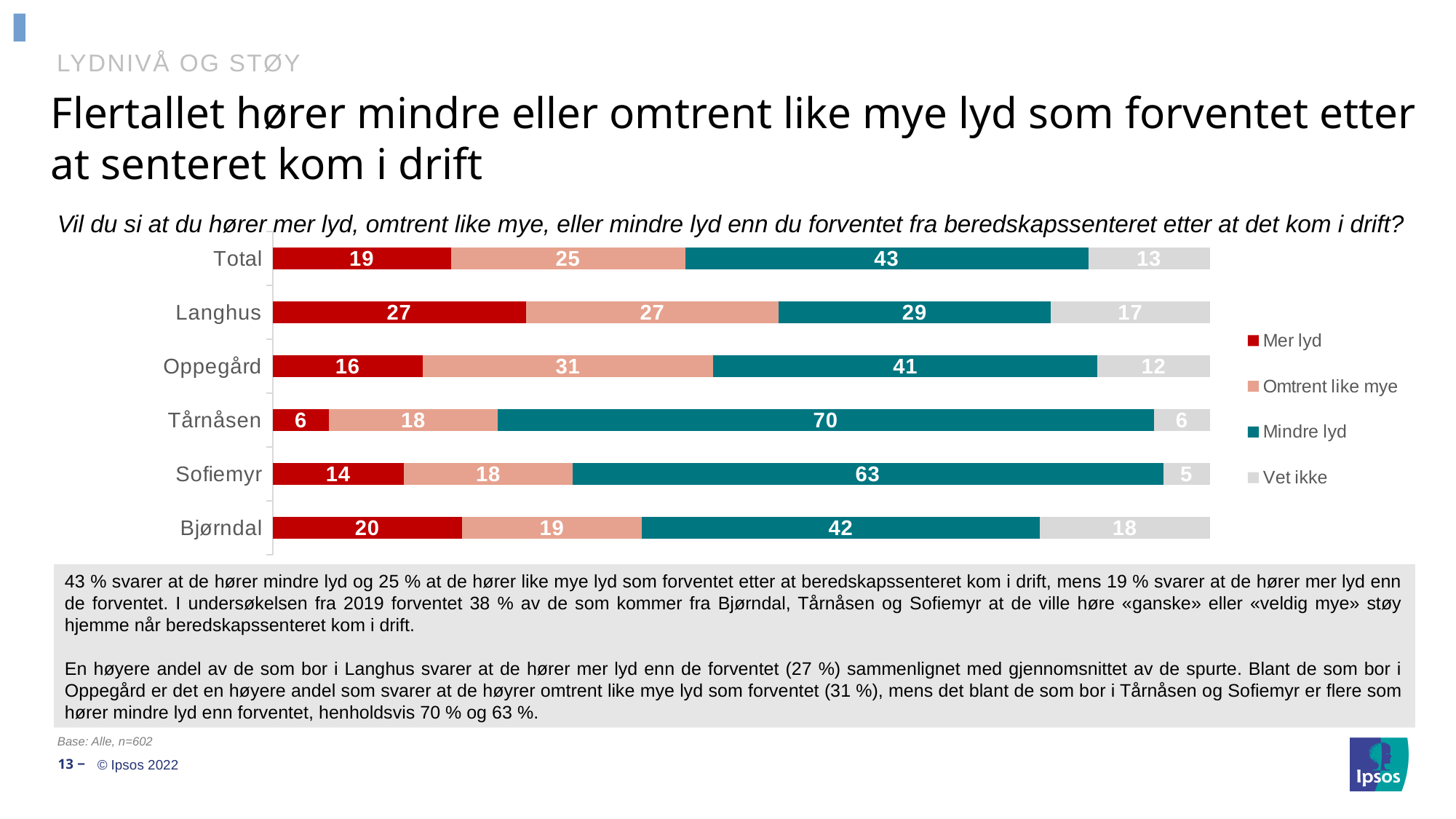
Which colour represents "Mindre lyd" in the chart? Teal What is the total of the stacked bar for Bjørndal? 99 What is the value for "Omtrent like mye" for Oppegård? 31 What is the value for "Mindre lyd" for Tårnåsen? 70 What is the value for "Vet ikke" for Bjørndal? 18 What is the difference between the "Mindre lyd" values for Tårnåsen and Sofiemyr? 7 What kind of chart is shown on the slide? Stacked bar chart How many categories are shown on the chart? 6 Which category has the highest value for "Mer lyd"? Langhus Which category has the lowest value for "Mindre lyd"? Langhus Which is larger: the "Mer lyd" value for Bjørndal or for Oppegård? Bjørndal How many series does the legend list? 4